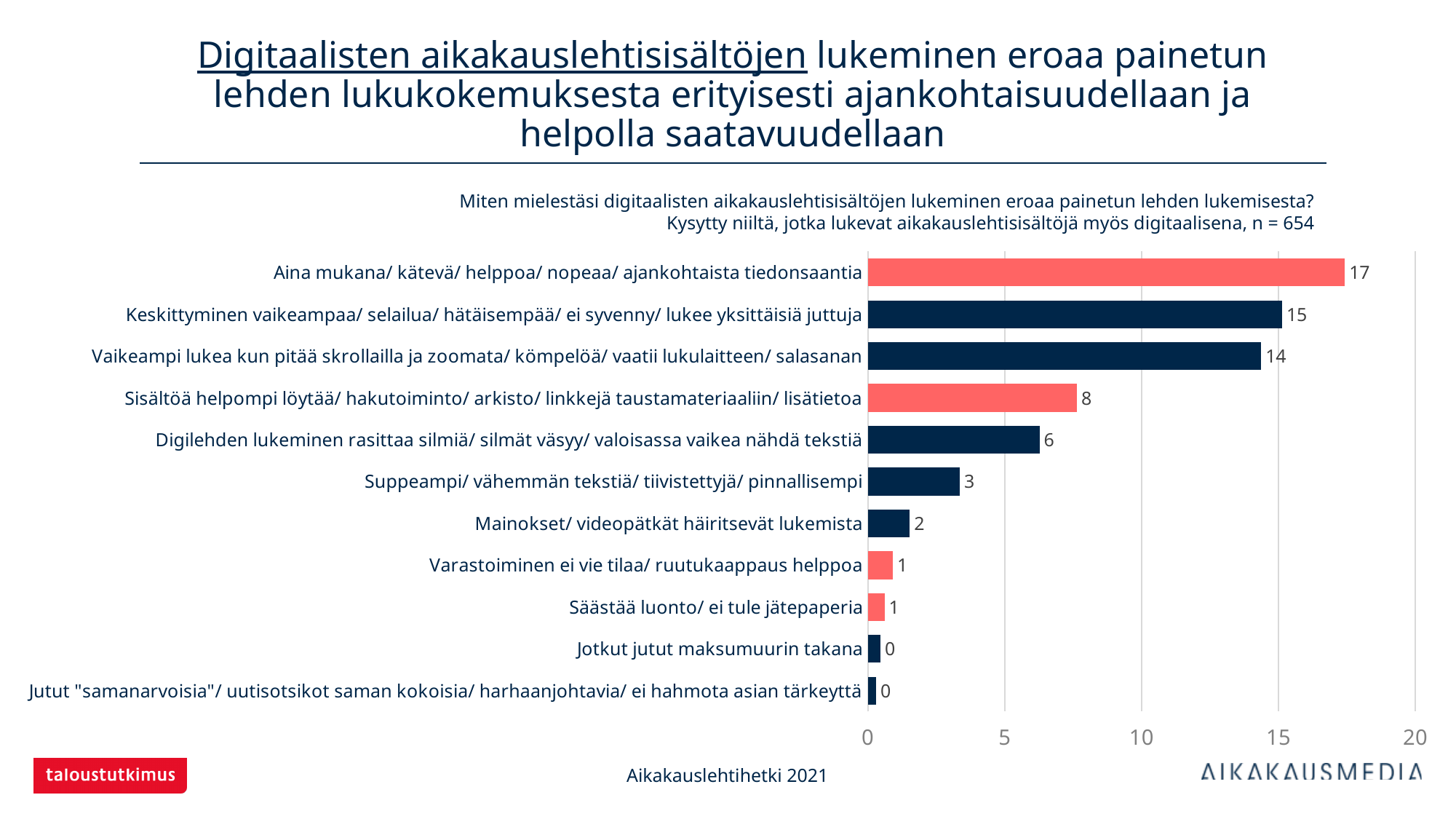
What is the sample size (n) stated in the chart subtitle? 654 Is the value for "Keskittyminen vaikeampaa/ selailua/ hätäisempää/ ei syvenny/ lukee yksittäisiä juttuja" greater or less than 10? greater What kind of chart is shown on the slide? Bar chart What is the value for "Sisältöä helpompi löytää/ hakutoiminto/ arkisto/ linkkejä taustamateriaaliin/ lisätietoa"? 8 Which is larger: the value for "Sisältöä helpompi löytää/ hakutoiminto/ arkisto/ linkkejä taustamateriaaliin/ lisätietoa" or "Suppeampi/ vähemmän tekstiä/ tiivistettyjä/ pinnallisempi"? Sisältöä helpompi löytää/ hakutoiminto/ arkisto/ linkkejä taustamateriaaliin/ lisätietoa How many categories are shown in the chart? 11 What is the value for "Aina mukana/ kätevä/ helppoa/ nopeaa/ ajankohtaista tiedonsaantia"? 17 What is the value for "Mainokset/ videopätkät häiritsevät lukemista"? 2 Which category has the highest value? Aina mukana/ kätevä/ helppoa/ nopeaa/ ajankohtaista tiedonsaantia What is the difference between the values for "Aina mukana/ kätevä/ helppoa/ nopeaa/ ajankohtaista tiedonsaantia" and "Digilehden lukeminen rasittaa silmiä/ silmät väsyy/ valoisassa vaikea nähdä tekstiä"? 11 What is the difference between the values for "Keskittyminen vaikeampaa/ selailua/ hätäisempää/ ei syvenny/ lukee yksittäisiä juttuja" and "Vaikeampi lukea kun pitää skrollailla ja zoomata/ kömpelöä/ vaatii lukulaitteen/ salasanan"? 1 What is the value for "Jotkut jutut maksumuurin takana"? 0